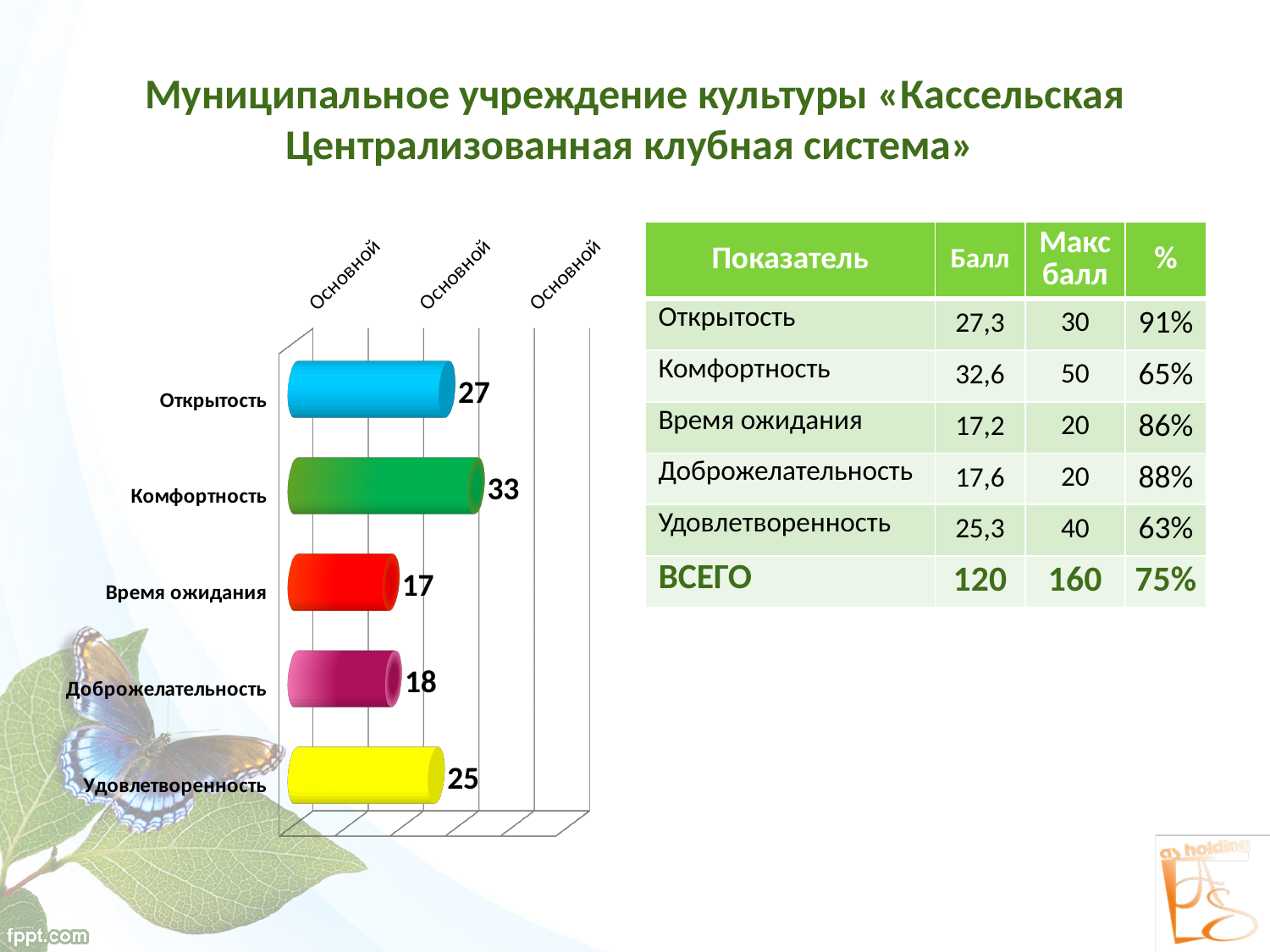
What is the difference between the values for Комфортность and Открытость in the bar chart? 6 What is the difference between the values for Удовлетворенность and Доброжелательность in the bar chart? 7 Which category has the highest value in the bar chart? Комфортность Which category has the lowest value in the bar chart? Время ожидания What value is shown for Комфортность in the bar chart? 33 What value is shown for Открытость in the bar chart? 27 What value is shown for Время ожидания in the bar chart? 17 What type of chart is shown on the slide? Bar chart Which has a larger value in the bar chart, Открытость or Удовлетворенность? Открытость What value is shown for Удовлетворенность in the bar chart? 25 What colour is the bar for Время ожидания in the chart? Red How many categories are shown in the bar chart? 5